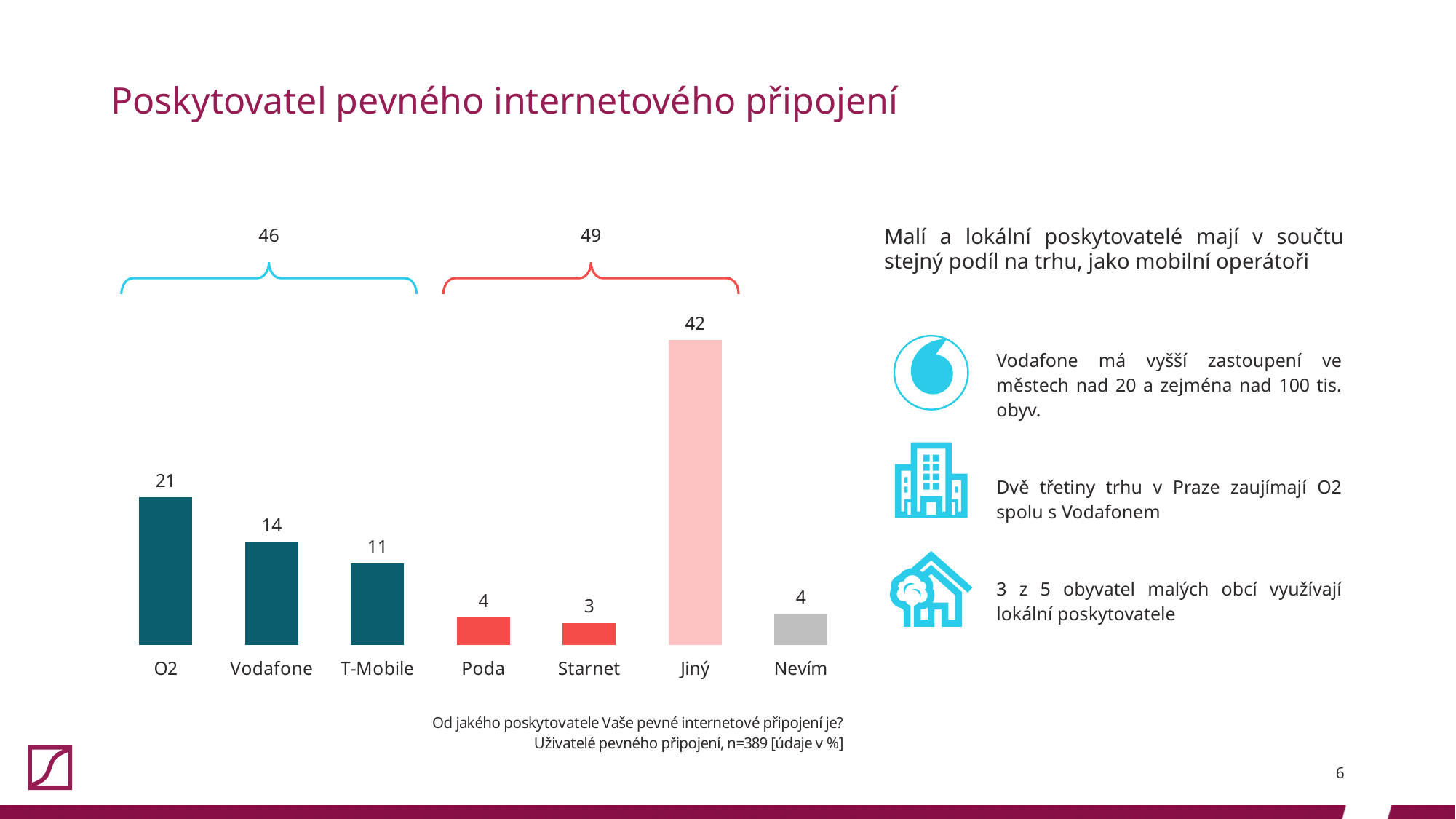
What is the value for Vodafone? 14 What is the sample size (n) stated in the chart note? n=389 What is the value for Starnet? 3 How many categories are shown on the x axis? 7 What is the combined value shown by the bracket over O2, Vodafone and T-Mobile? 46 Which category has the highest value? Jiný What is the value for O2? 21 Which is larger, the value for Vodafone or the value for Poda? Vodafone What is the difference between the values for O2 and T-Mobile? 10 What is the combined value shown by the bracket over Poda, Starnet and Jiný? 49 Which category has the lowest value? Starnet What kind of chart is shown on the slide? Bar chart